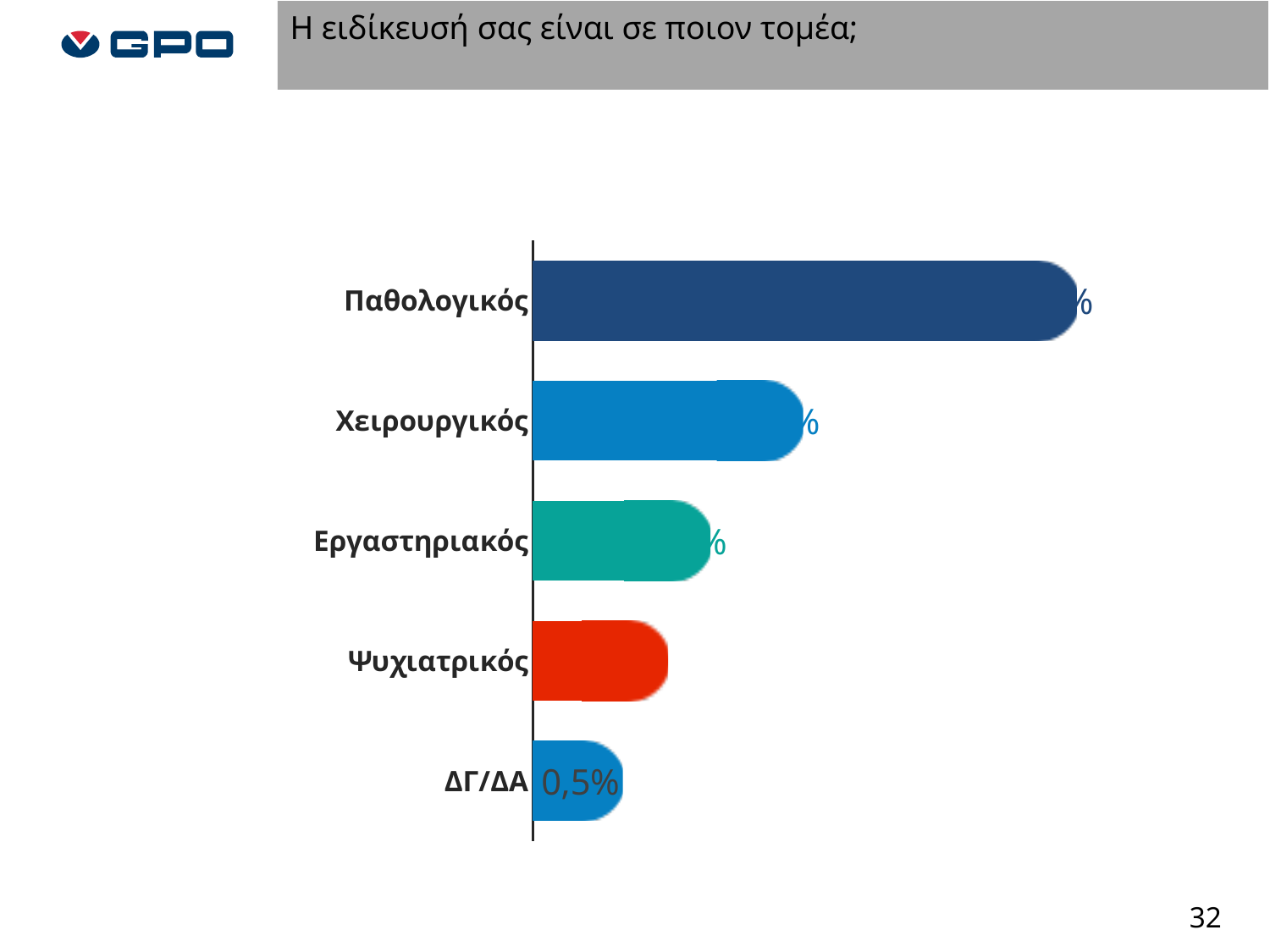
Which is larger, the value for Παθολογικός or the value for Χειρουργικός? Παθολογικός What is the title of the slide containing the chart? Η ειδίκευσή σας είναι σε ποιον τομέα; Which category has the longest bar? Παθολογικός Which is larger, the value for Χειρουργικός or the value for Εργαστηριακός? Χειρουργικός Which category has the shortest bar? ΔΓ/ΔΑ Which is larger, the value for Ψυχιατρικός or the value for Εργαστηριακός? Εργαστηριακός Which category is listed at the top of the chart? Παθολογικός What type of chart is shown on the slide? bar chart How many categories are shown in the chart? 5 What is the value shown for ΔΓ/ΔΑ? 0,5%